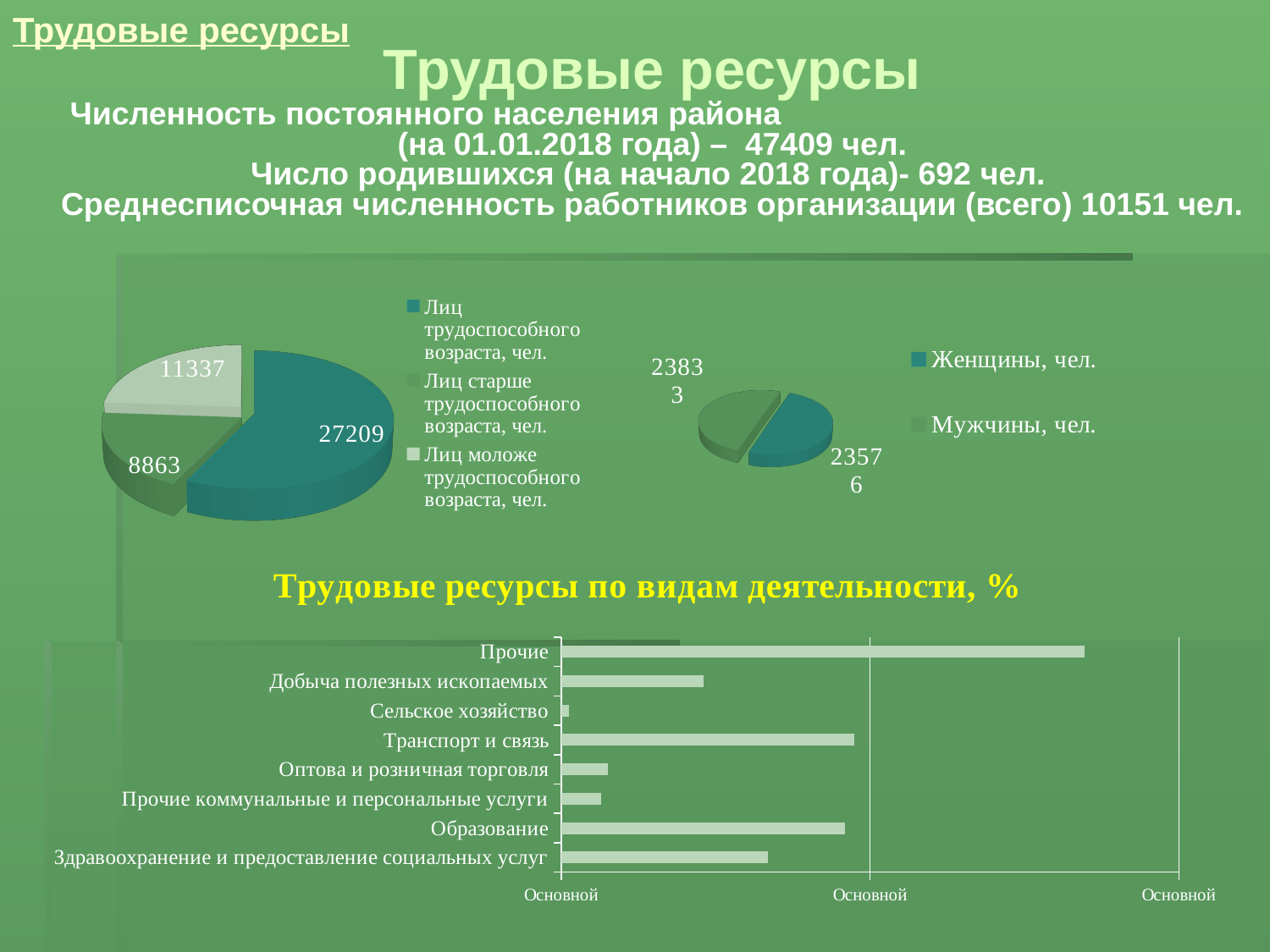
In the left pie chart, what is the value for 'Лиц старше трудоспособного возраста, чел.'? 8863 In the left pie chart, what is the difference between the values for 'Лиц старше трудоспособного возраста' and 'Лиц моложе трудоспособного возраста'? 2474 In the bottom chart 'Трудовые ресурсы по видам деятельности, %', which category has the longest bar? Прочие In the left pie chart, what is the value for 'Лиц трудоспособного возраста, чел.'? 27209 How many categories are shown in the bottom chart 'Трудовые ресурсы по видам деятельности, %'? 8 In the bottom chart 'Трудовые ресурсы по видам деятельности, %', which is larger: 'Транспорт и связь' or 'Оптова и розничная торговля'? Транспорт и связь How many series does the legend of the right pie chart list? 2 In the bottom chart 'Трудовые ресурсы по видам деятельности, %', which category has the shortest bar? Сельское хозяйство In the left pie chart, what is the value for 'Лиц моложе трудоспособного возраста, чел.'? 11337 What kind of chart is the bottom chart titled 'Трудовые ресурсы по видам деятельности, %'? bar chart In the left pie chart, which category has the smallest slice? Лиц старше трудоспособного возраста, чел. In the left pie chart, which category has the largest slice? Лиц трудоспособного возраста, чел.